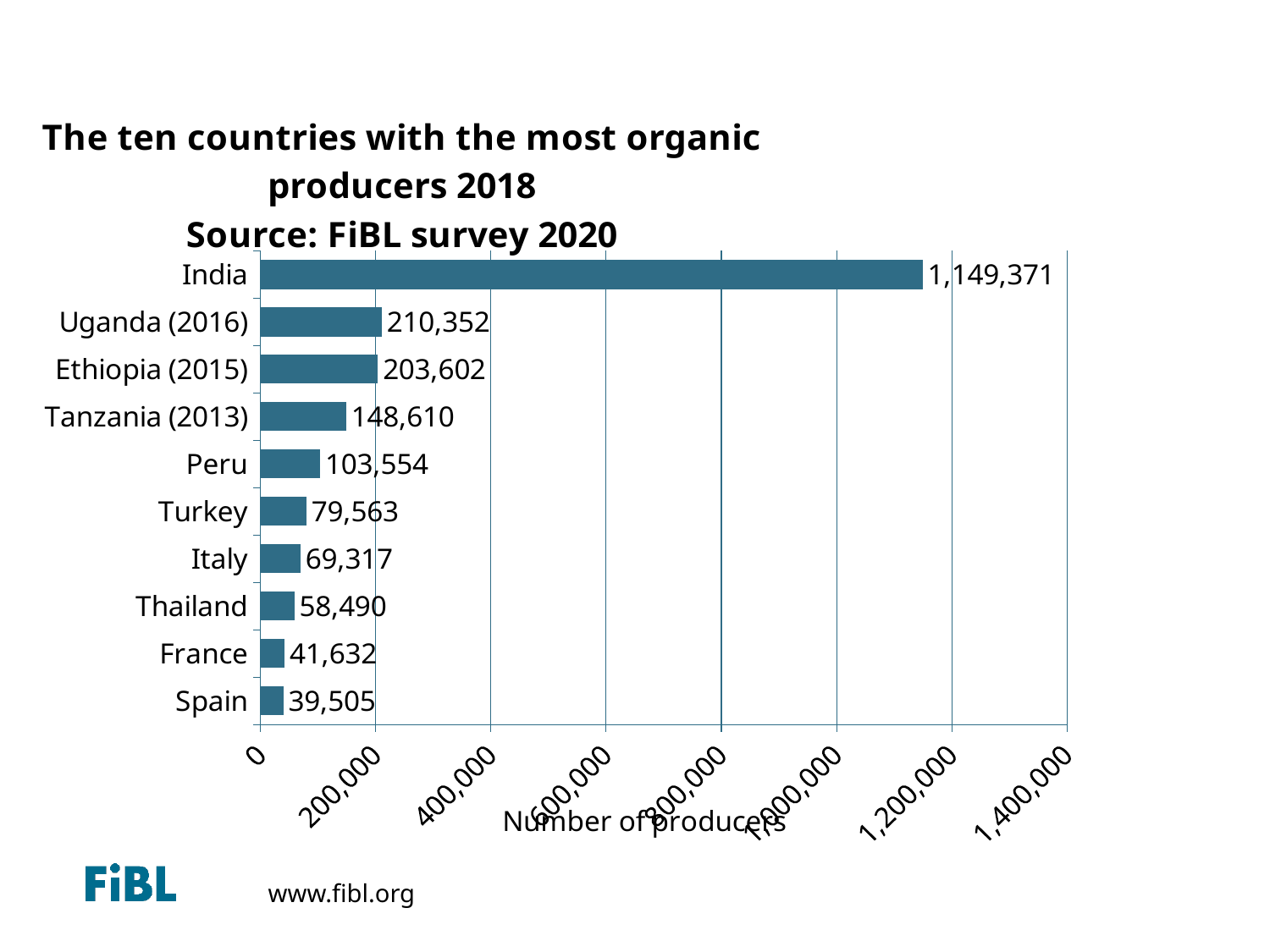
How many organic producers does India have according to the chart? 1,149,371 Is the value for Tanzania (2013) greater or less than 200,000? less Which country has the fewest organic producers in the chart? Spain What is the number of producers shown for Peru? 103,554 What is the difference in number of producers between France and Spain? 2,127 Which has more organic producers, Turkey or Italy? Turkey What type of chart is shown on the slide? bar chart What value is shown for Thailand? 58,490 Which country has the most organic producers in the chart? India How many countries are shown in the chart? 10 What is the label of the horizontal axis? Number of producers What is the difference in number of producers between Uganda (2016) and Ethiopia (2015)? 6,750